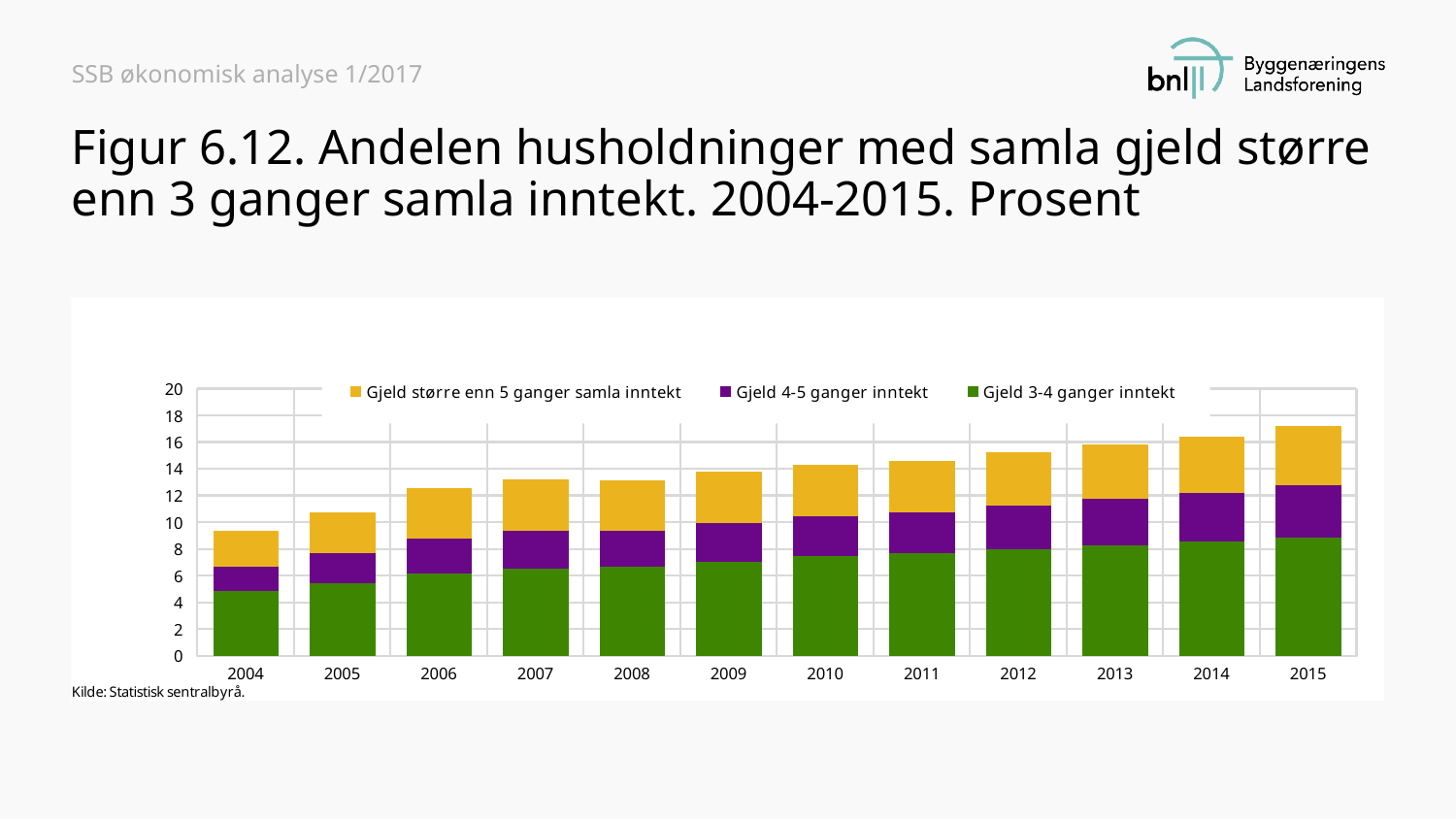
Do the total bar heights rise or fall from 2004 to 2015? Rise Is the value of the 'Gjeld 3-4 ganger inntekt' segment for 2004 greater or less than 6? less Which colour represents the series 'Gjeld 3-4 ganger inntekt' in the chart? Green Which year has the lowest total stacked bar? 2004 What kind of chart is shown on the slide? Stacked bar chart Which year has the highest total stacked bar? 2015 How many years (categories) are shown on the x axis of the chart? 12 Is the total stacked value for 2012 greater or less than 14? greater Which is larger, the total stacked bar for 2004 or for 2015? 2015 How many series does the chart's legend list? 3 Is the total stacked value for 2004 greater or less than 10? less